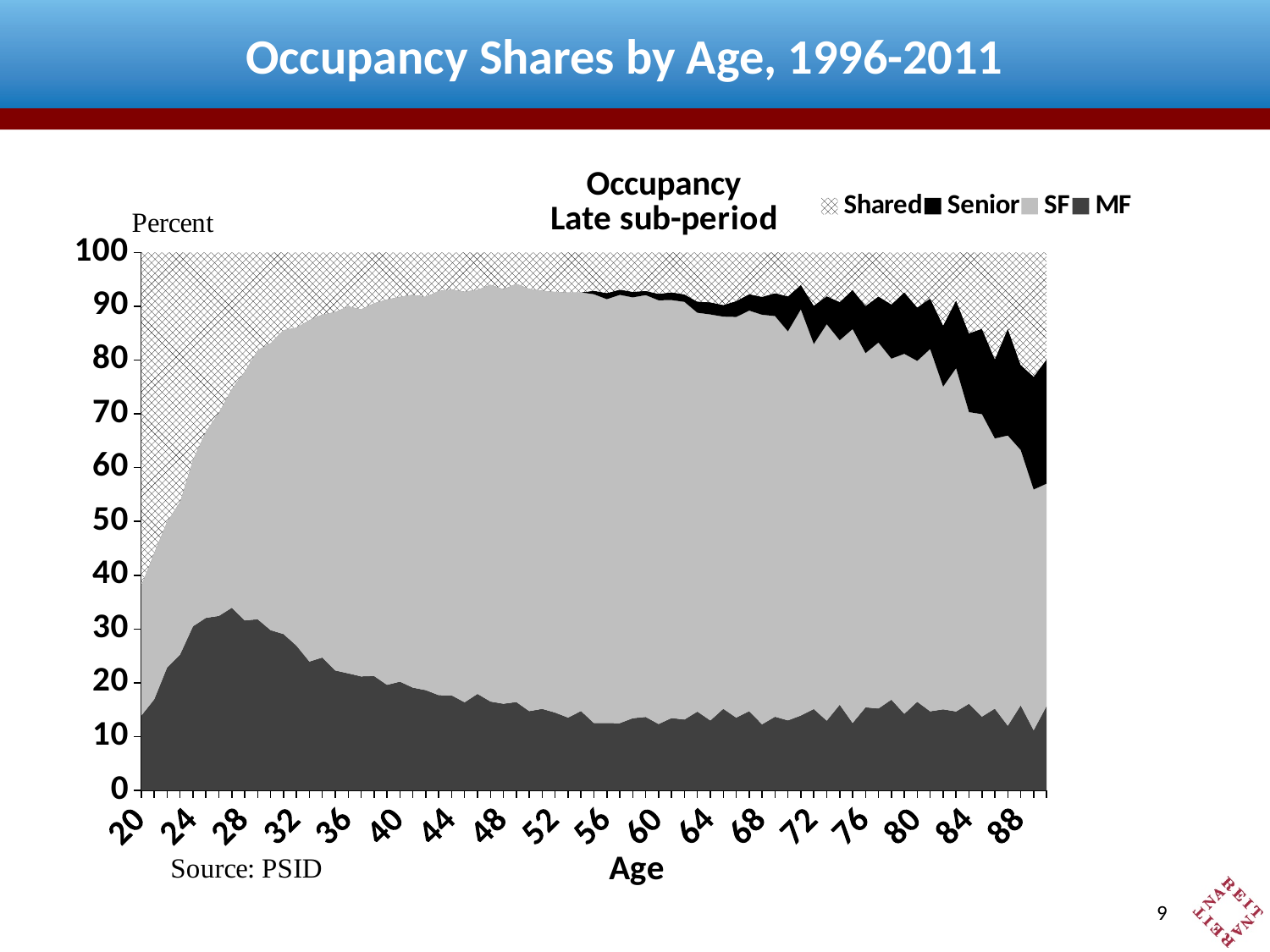
Does the Senior share rise or fall as age increases from 60 to 88? rise Is the combined MF plus SF share at age 20 greater or less than 50 percent? less What kind of chart is shown on the slide? Stacked area chart Is the combined MF plus SF share at age 48 greater or less than 90 percent? greater Which series has the larger share at age 20, MF or Shared? Shared How many series does the legend list? 4 Is the MF share at age 20 greater or less than 20 percent? less What is the title printed above the chart area? Occupancy Late sub-period What are the four series listed in the legend? Shared, Senior, SF, MF Does the MF share rise or fall as age increases from 28 to 60? fall